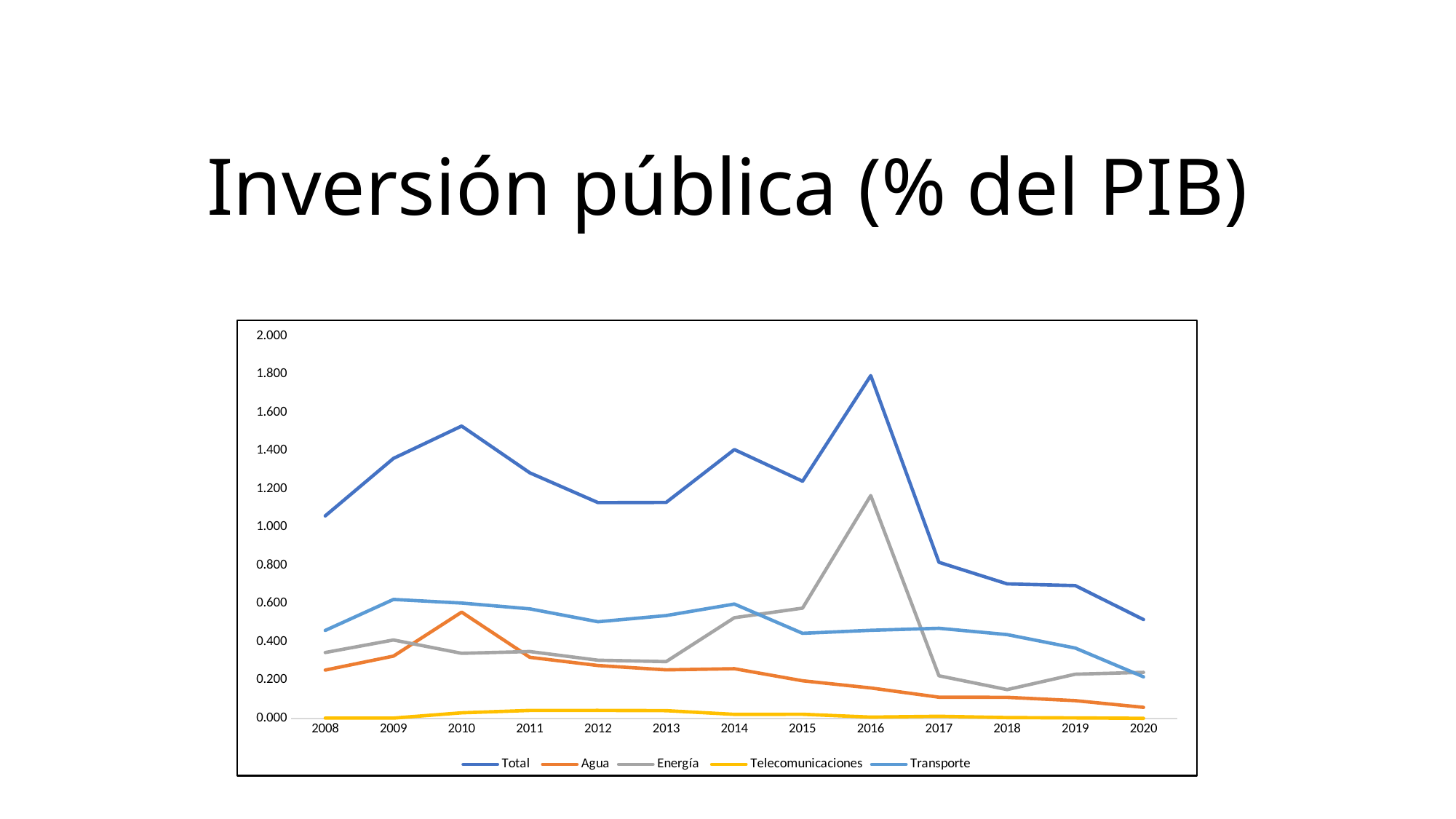
What kind of chart is shown on the slide? line chart In which year does the Agua series reach its highest value? 2010 How many series does the legend list? 5 Which series has the lowest values across all years? Telecomunicaciones Is the value for Energía in 2016 greater or less than 1.000? greater Is the value for Total in 2020 greater or less than 0.600? less Does the Total series rise or fall from 2016 to 2020? fall How many years are shown on the x axis? 13 Is the value for Total in 2016 greater or less than 1.600? greater In 2017, which is larger, Energía or Agua? Energía In which year does the Energía series reach its highest value? 2016 In which year does the Total series reach its highest value? 2016